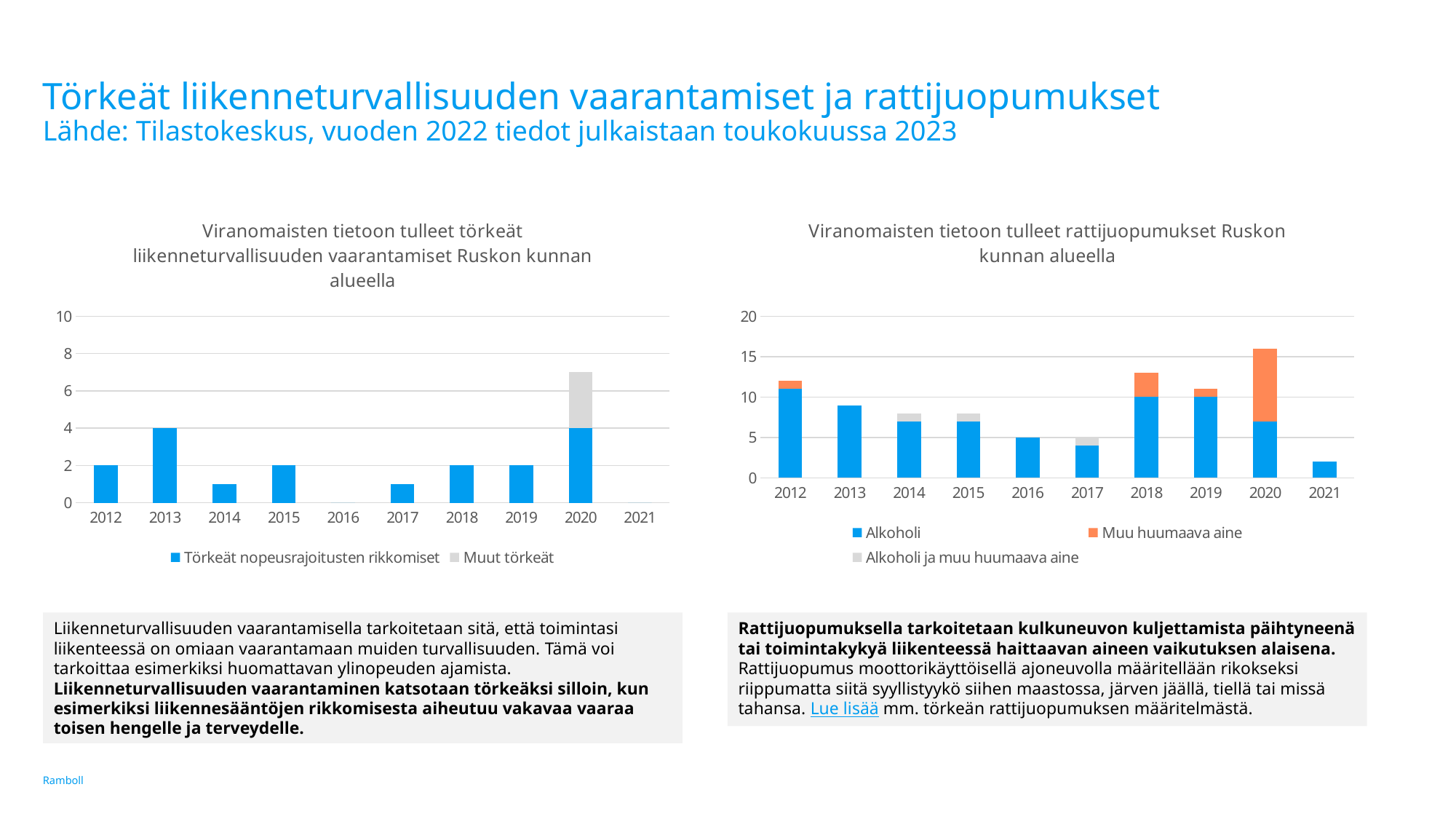
How many series does the legend of the left chart list? 2 In the right chart, what is the value for 2016? 5 In the left chart, what is the value for 2012? 2 In the left chart, which year has the highest total bar? 2020 What kind of chart is the left chart, 'Viranomaisten tietoon tulleet törkeät liikenneturvallisuuden vaarantamiset Ruskon kunnan alueella'? bar chart In the right chart, which colour represents 'Muu huumaava aine'? orange In the right chart, which year has the lowest total bar? 2021 In the left chart, what is the value for 2013? 4 How many series does the legend of the right chart, 'Viranomaisten tietoon tulleet rattijuopumukset Ruskon kunnan alueella', list? 3 In the right chart, which year has the highest total bar? 2020 How many years are shown on the x axis of the left chart? 10 In the right chart, is the total value for 2018 greater or less than 10? greater